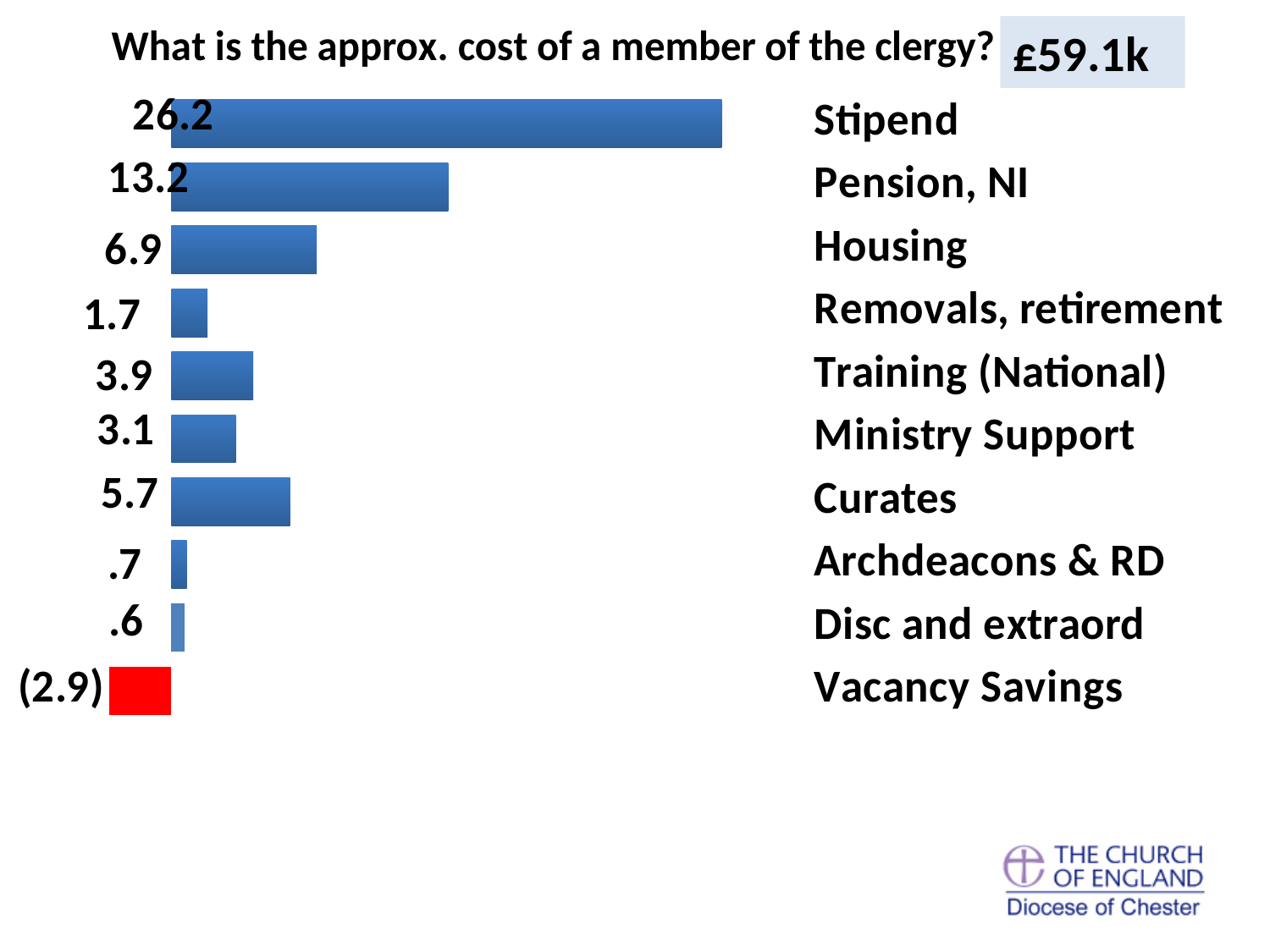
What kind of chart is shown on the slide? Bar chart What is the value shown for Curates? 5.7 What is the value shown for Pension, NI? 13.2 Which category's bar is coloured red? Vacancy Savings What is the value shown for Stipend? 26.2 What is the difference between the Housing value and the Curates value? 1.2 What is the difference between the Stipend value and the Pension, NI value? 13.0 What is the value shown for Vacancy Savings? (2.9) Which category has the smallest positive value? Disc and extraord How many categories are shown in the chart? 10 Which category has the largest bar? Stipend Which is larger, Training (National) or Ministry Support? Training (National)